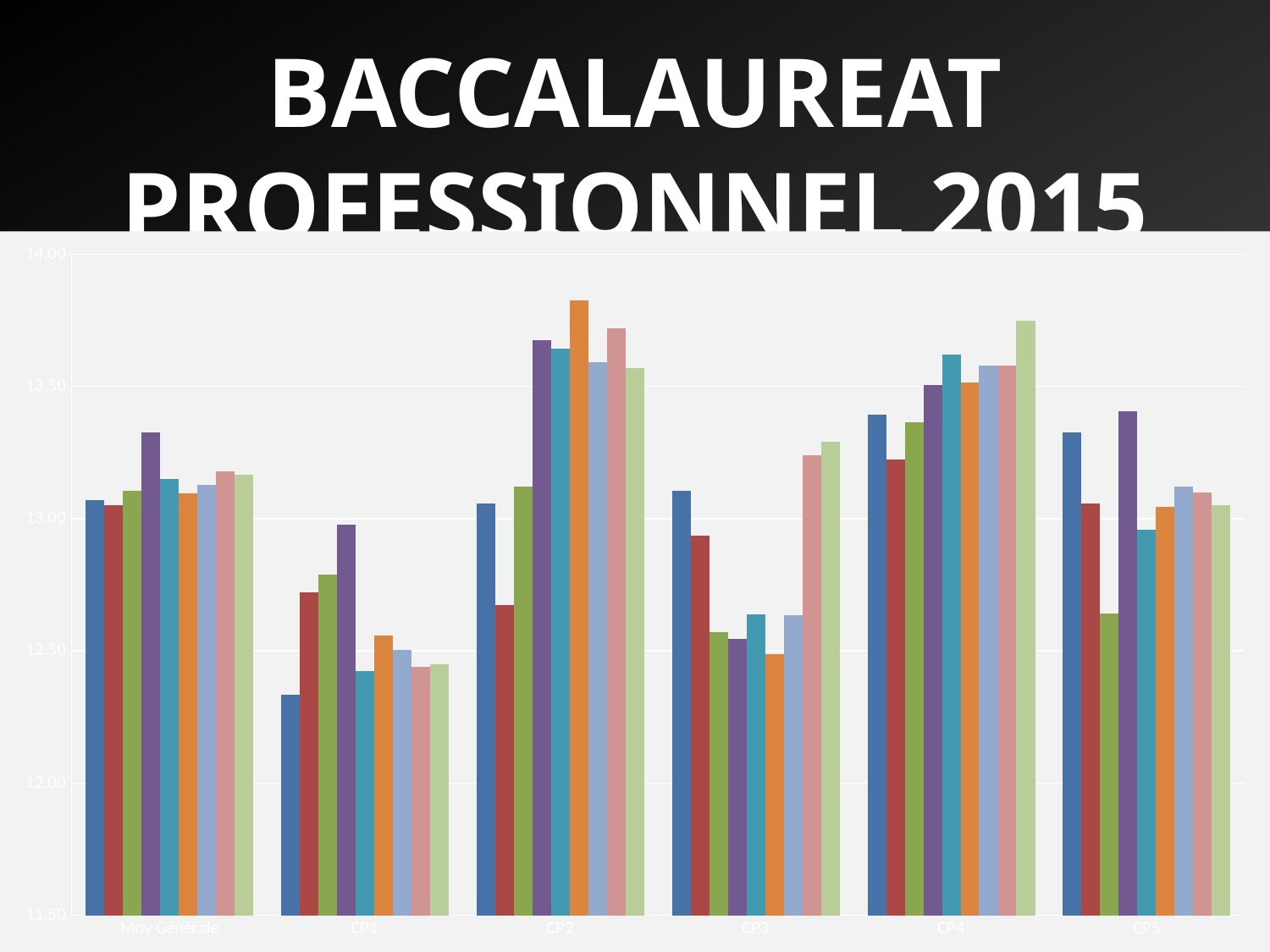
Which is larger: the first (blue) bar for Moy Générale or the first (blue) bar for CP1? Moy Générale Is the value of the first (blue) bar for CP3 greater or less than 13.00? greater Is the value of the last (light green) bar for CP4 greater or less than 13.50? greater Is the value of the first (blue) bar for CP1 greater or less than 12.50? less Which category contains the tallest bar on the chart? CP2 How many categories are shown along the x axis of the chart? 6 What is the title shown above the chart? BACCALAUREAT PROFESSIONNEL 2015 What is the highest value shown on the chart's vertical axis? 14.00 Which category contains the shortest bar on the chart? CP1 What kind of chart is shown on the slide? bar chart